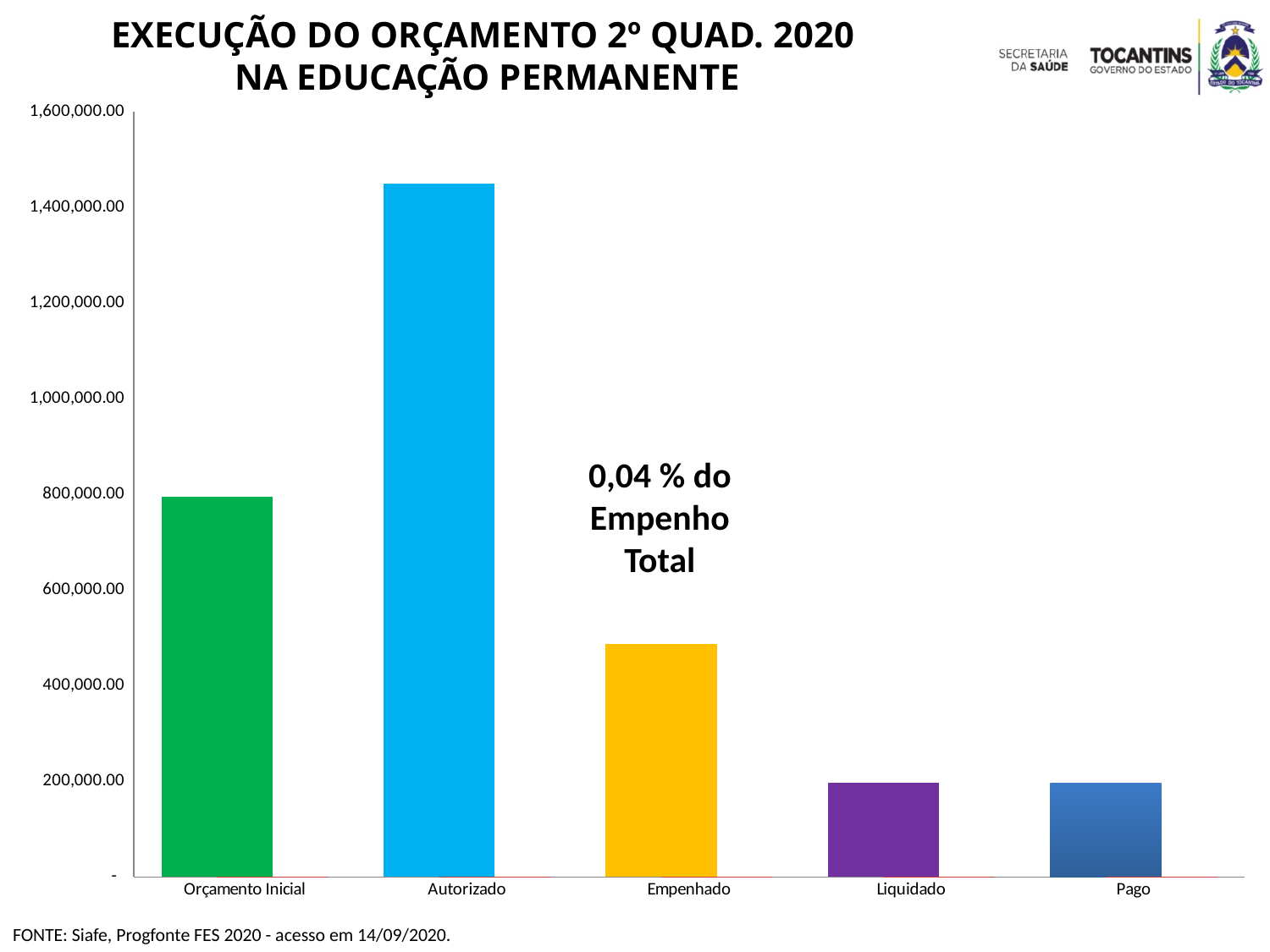
Is the value for Liquidado greater or less than 400,000.00? less Which is larger, the value for Orçamento Inicial or the value for Empenhado? Orçamento Inicial What text annotation is printed above the Empenhado bar? 0,04 % do Empenho Total What kind of chart is shown on the slide? bar chart Which is larger, the value for Autorizado or the value for Orçamento Inicial? Autorizado Which category has the highest value in the chart? Autorizado What is the title of the chart? EXECUÇÃO DO ORÇAMENTO 2º QUAD. 2020 NA EDUCAÇÃO PERMANENTE Is the value for Empenhado greater or less than 600,000.00? less Is the value for Orçamento Inicial greater or less than 600,000.00? greater How many categories are plotted on the x axis of the chart? 5